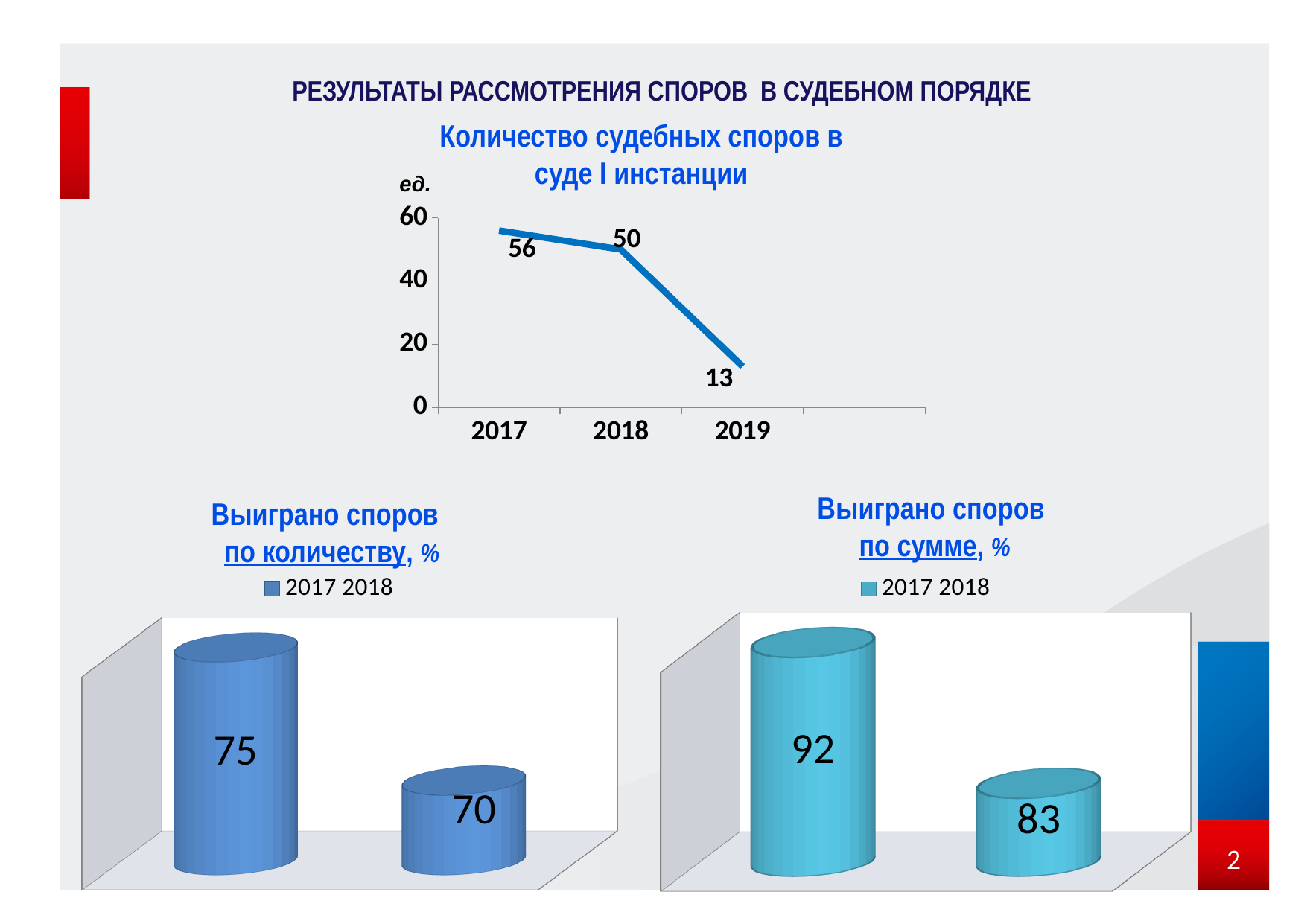
In the chart 'Выиграно споров по количеству, %', what is the difference between the 2017 and 2018 values? 5 In the chart 'Выиграно споров по сумме, %', what is the value for 2018? 83 How many data points are plotted in the chart 'Количество судебных споров в суде I инстанции'? 3 In the chart 'Выиграно споров по количеству, %', what is the value for 2017? 75 In the chart 'Количество судебных споров в суде I инстанции', what is the difference between the 2018 and 2019 values? 37 In the chart 'Количество судебных споров в суде I инстанции', which year has the lowest value? 2019 In the chart 'Количество судебных споров в суде I инстанции', what is the value for 2019? 13 In the chart 'Количество судебных споров в суде I инстанции', do the values rise or fall from 2017 to 2019? fall What kind of chart is 'Выиграно споров по сумме, %'? bar chart In the chart 'Количество судебных споров в суде I инстанции', what is the value for 2017? 56 What kind of chart is 'Количество судебных споров в суде I инстанции'? line chart In the chart 'Выиграно споров по сумме, %', which year has the higher value, 2017 or 2018? 2017